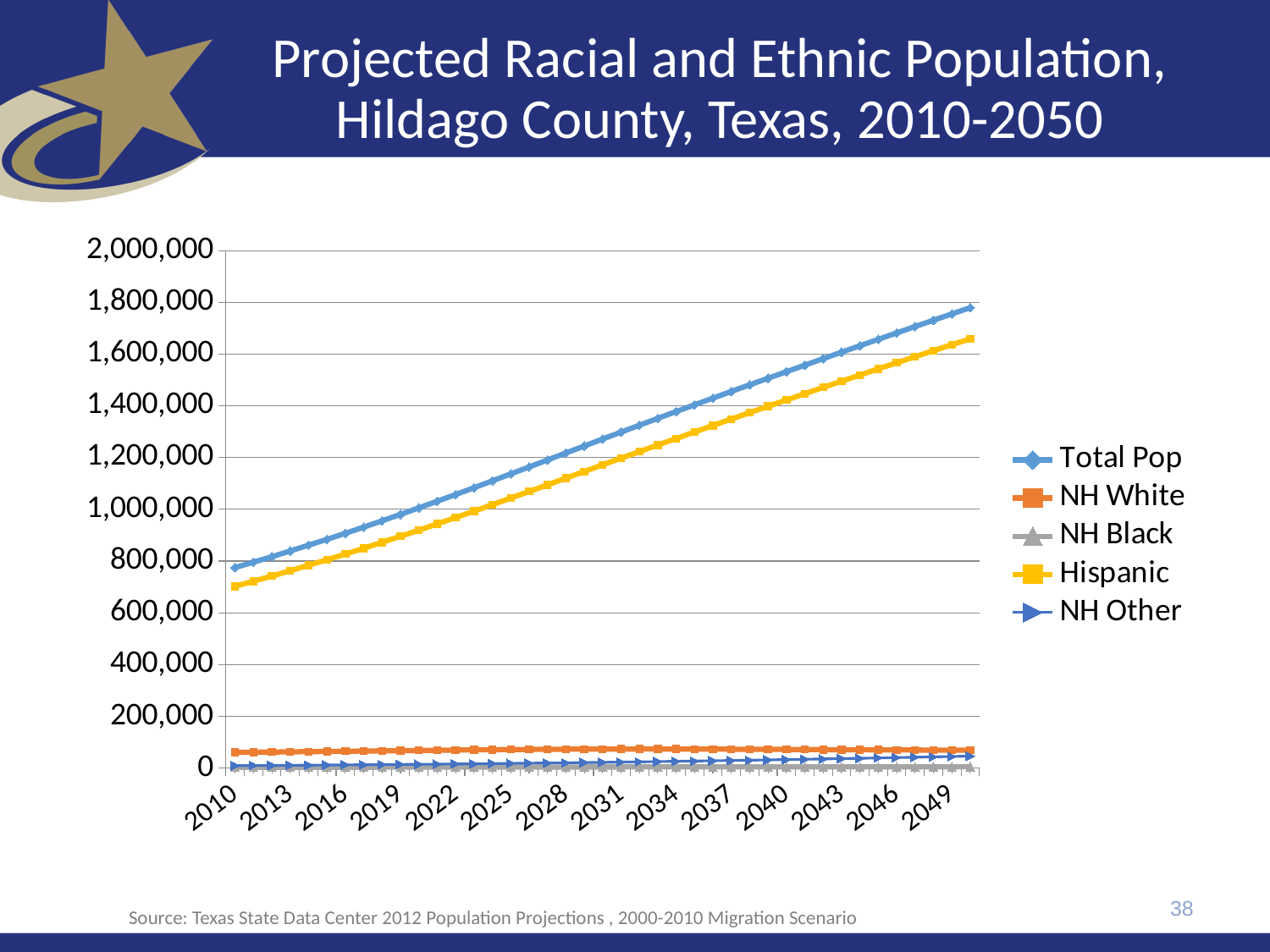
In 2049, which is larger: Total Pop or Hispanic? Total Pop How many series does the legend list? 5 Is the Total Pop value for 2010 greater or less than 1,000,000? less What kind of chart is shown on the slide? line chart Is the NH White value for 2049 greater or less than 200,000? less Does the Total Pop line rise or fall from 2010 to 2049? rise Is the Total Pop value for 2049 greater or less than 2,000,000? less Which series has the highest values across the whole chart? Total Pop What is the title of the chart on the slide? Projected Racial and Ethnic Population, Hildago County, Texas, 2010-2050 Does the Hispanic line rise or fall from 2010 to 2049? rise